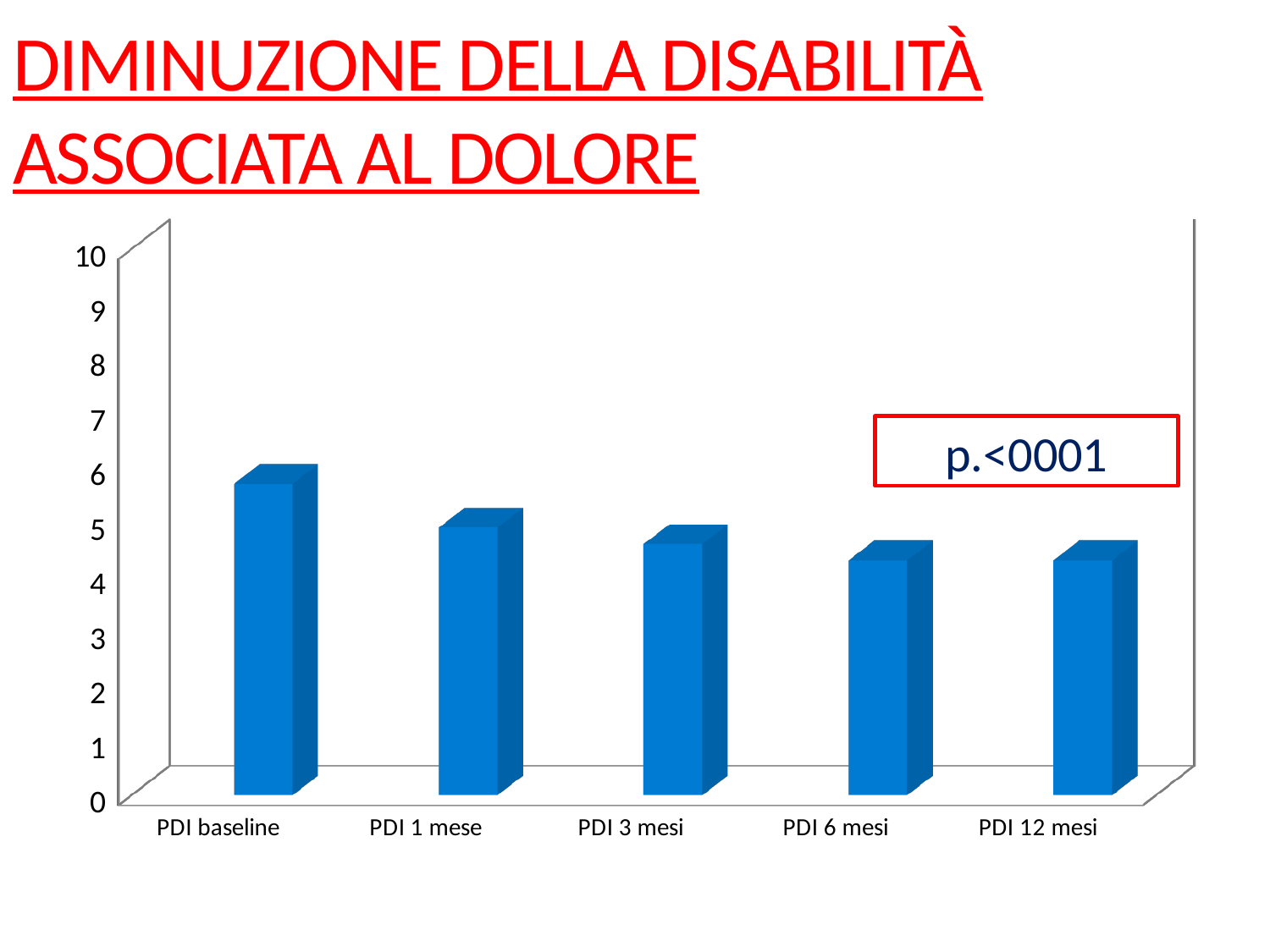
What kind of chart is shown on the slide? Bar chart Is the value for PDI 6 mesi greater or less than 5? less Which category has the highest bar? PDI baseline Is the value for PDI 3 mesi greater or less than 3? greater How many categories are plotted on the chart? 5 Is the value for PDI baseline greater or less than 5? greater Which is larger, the value for PDI baseline or the value for PDI 12 mesi? PDI baseline What is the title of the slide? DIMINUZIONE DELLA DISABILITÀ ASSOCIATA AL DOLORE What p-value is shown in the box on the chart? p.<0001 Do the values rise or fall from PDI baseline to PDI 12 mesi? Fall Which is larger, the value for PDI 1 mese or the value for PDI 6 mesi? PDI 1 mese